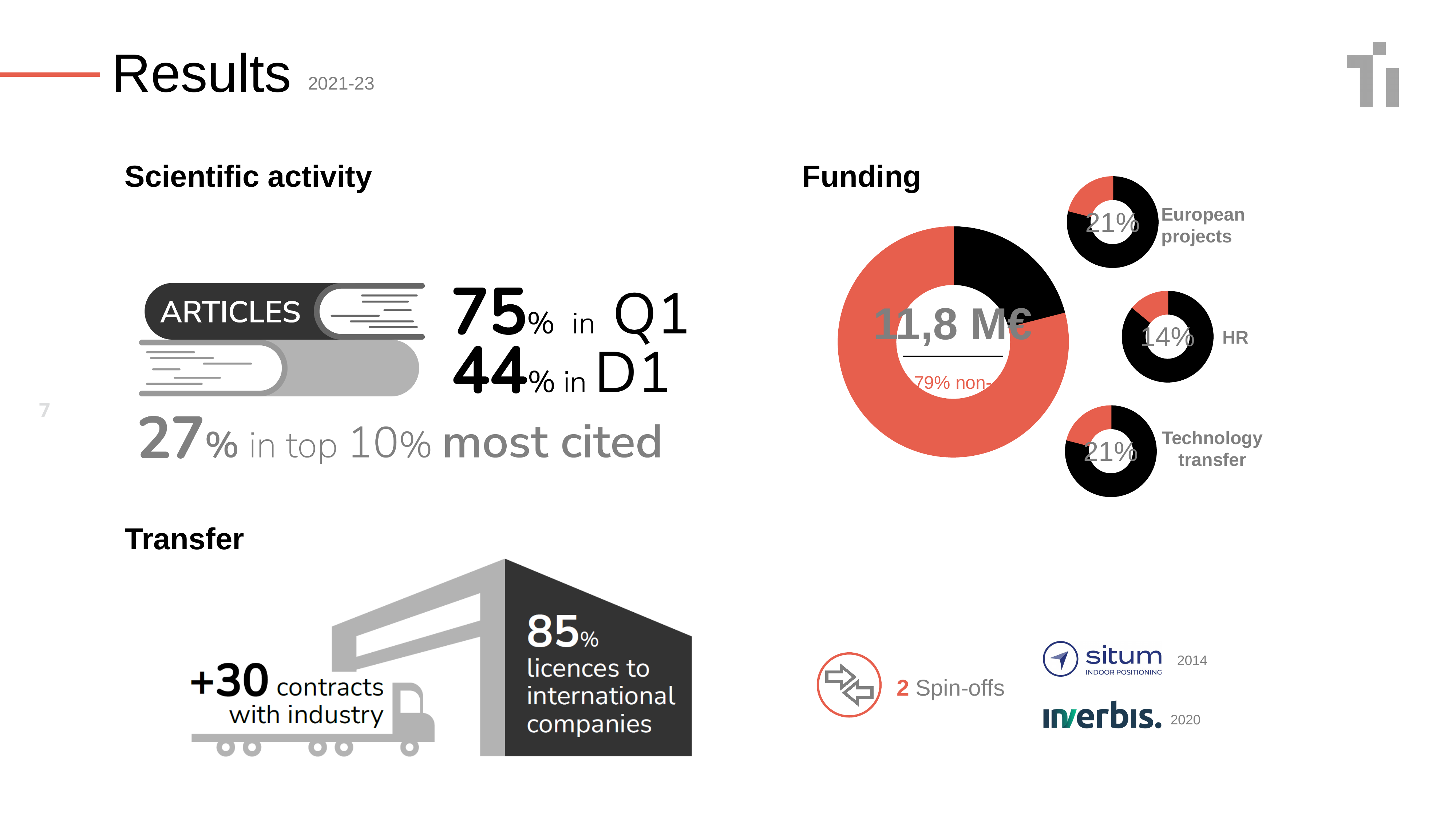
In the large funding donut chart, which colour fills the larger portion of the ring? Red In the Funding section, what is the difference between the percentage for Technology transfer and the percentage for HR? 7 percentage points In the Funding section, is the percentage for HR greater or less than 20%? less What kind of chart is used to show the 11,8 M€ funding figure? Donut (pie) chart In the Funding section, what percentage is shown in the small donut chart labelled European projects? 21% What is the heading above the donut charts on the right side of the slide? Funding In the Funding section, which is larger: the percentage for European projects or the percentage for HR? European projects In the Funding section, what percentage is shown in the small donut chart labelled HR? 14% In the Funding section, what value is shown in the centre of the large donut chart? 11,8 M€ How many small donut charts are shown next to the large funding donut chart? 3 In the Funding section, what percentage is shown in the small donut chart labelled Technology transfer? 21% Among the three small donut charts in the Funding section, which category has the lowest percentage? HR